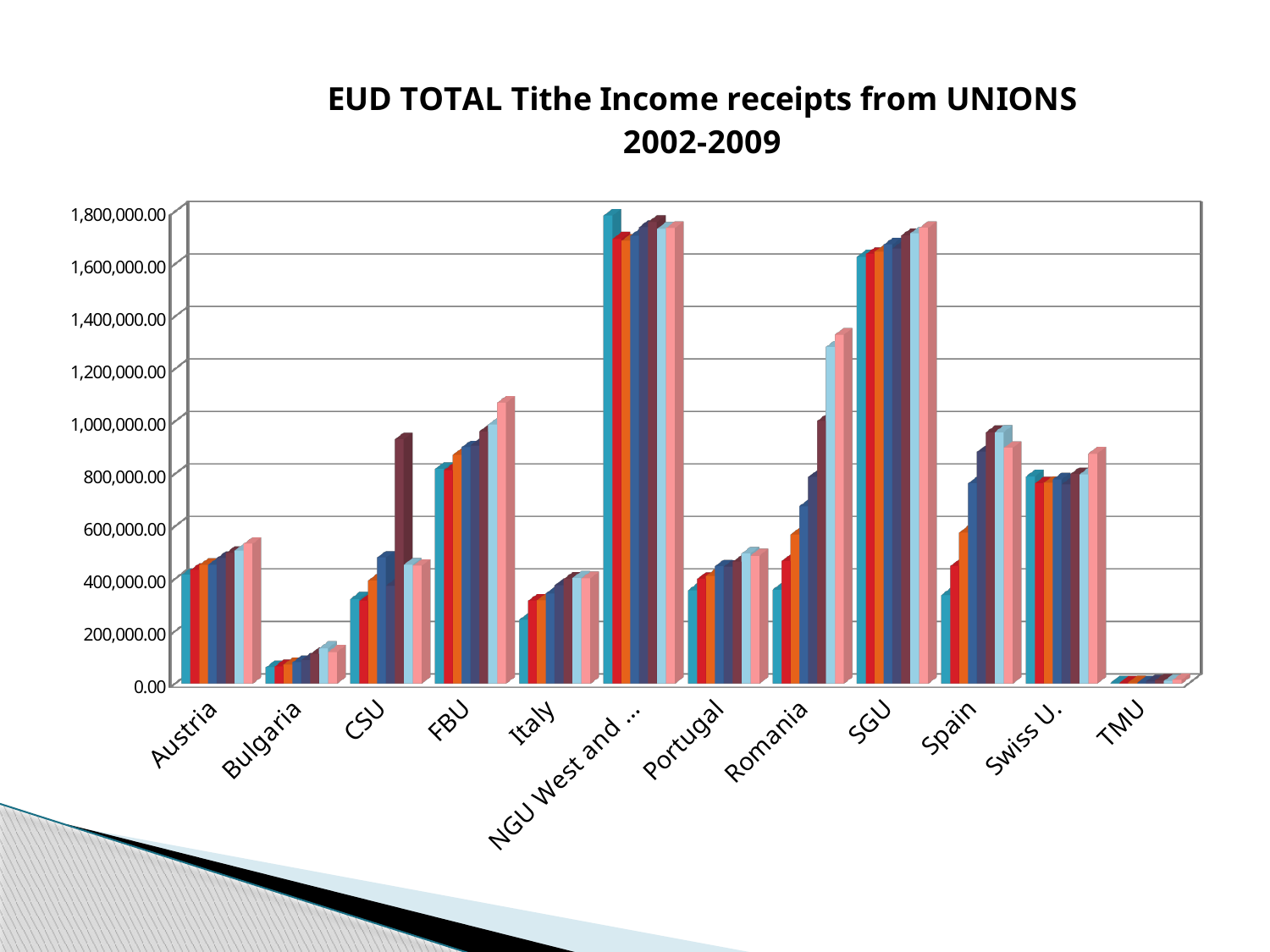
Which union has larger values, SGU or Spain? SGU Are the values for TMU greater or less than 200,000.00? less What is the title of the chart? EUD TOTAL Tithe Income receipts from UNIONS 2002-2009 Which union has the lowest tithe income bars? TMU How many unions (categories) are shown on the x axis? 12 Are the values for SGU greater or less than 1,400,000.00? greater Do the bars for Romania rise or fall from left to right within the group? rise What kind of chart is shown on the slide? bar chart Which union has the highest tithe income bars? NGU West and ... Are the values for Bulgaria greater or less than 200,000.00? less Which union has larger values, Swiss U. or Bulgaria? Swiss U.